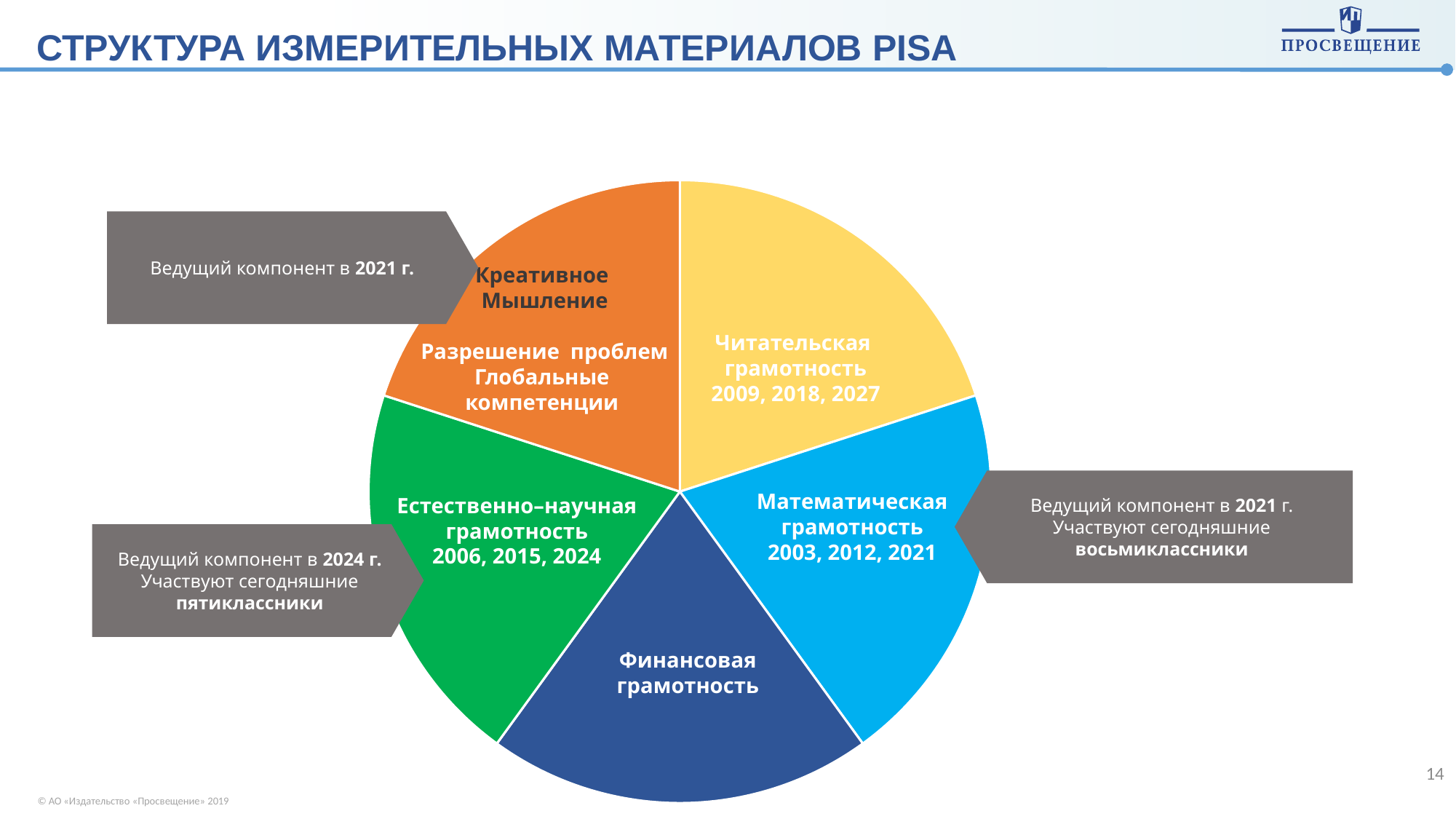
Which years are listed on the slice labelled Читательская грамотность? 2009, 2018, 2027 What kind of chart is shown on the slide? Pie chart How many slices does the pie chart have? 5 Which slice of the pie chart is coloured green? Естественно–научная грамотность Which years are listed on the slice labelled Естественно–научная грамотность? 2006, 2015, 2024 What is the title of the slide containing the pie chart? СТРУКТУРА ИЗМЕРИТЕЛЬНЫХ МАТЕРИАЛОВ PISA Which slice of the pie chart is coloured orange? Креативное мышление / Разрешение проблем / Глобальные компетенции Which years are listed on the slice labelled Математическая грамотность? 2003, 2012, 2021 What colour is the slice labelled Финансовая грамотность? Dark blue Which slice of the pie chart is coloured yellow? Читательская грамотность